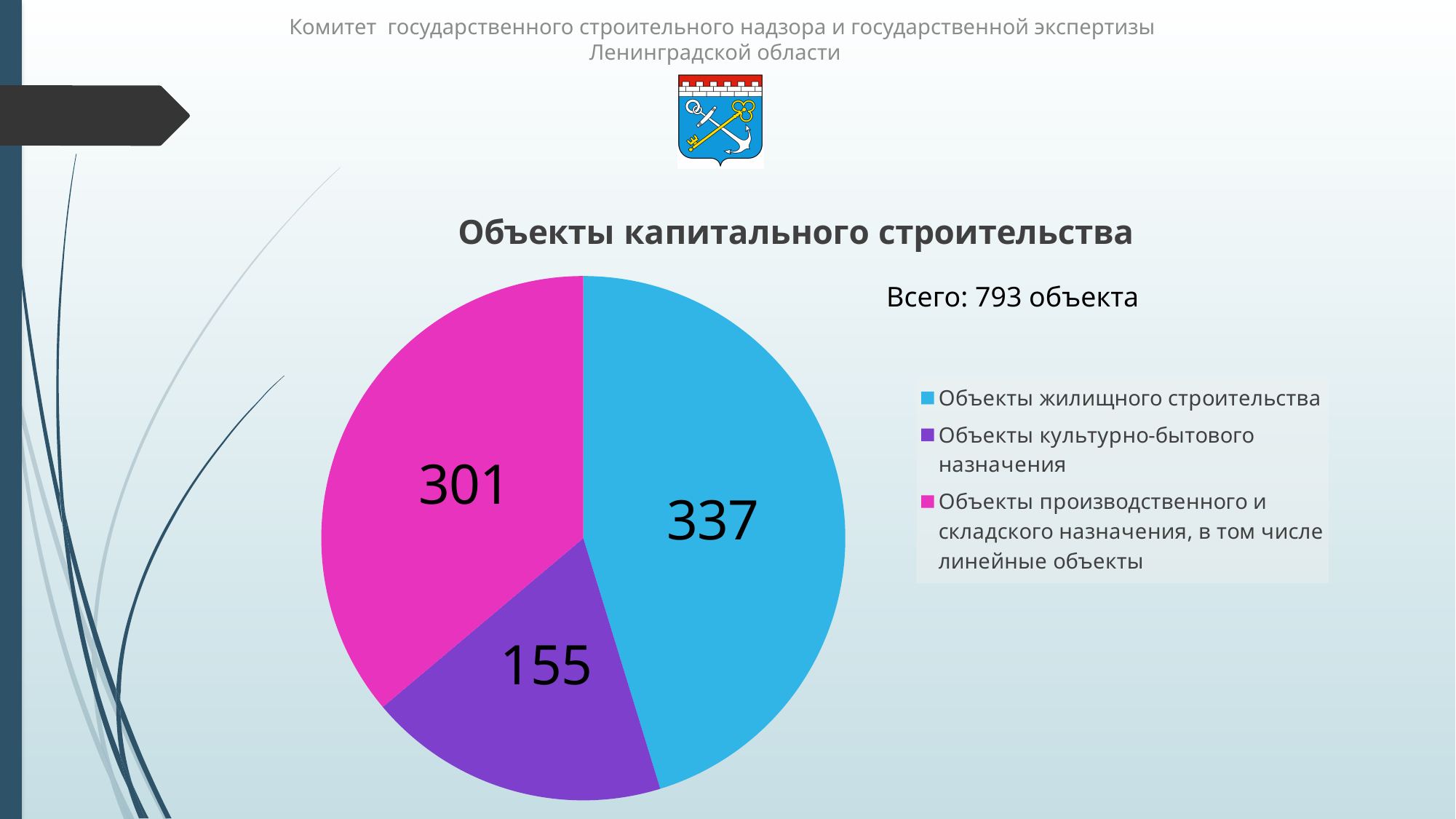
Which is larger: the value for Объекты жилищного строительства or the value for Объекты производственного и складского назначения? Объекты жилищного строительства How many entries does the legend list? 3 Which category has the largest slice of the pie? Объекты жилищного строительства What is the value for Объекты жилищного строительства? 337 What is the title of the chart? Объекты капитального строительства What is the value for Объекты культурно-бытового назначения? 155 How many slices does the pie chart have? 3 Which category has the smallest slice of the pie? Объекты культурно-бытового назначения What is the value for Объекты производственного и складского назначения, в том числе линейные объекты? 301 What is the difference between the values for Объекты жилищного строительства and Объекты культурно-бытового назначения? 182 What type of chart is shown on the slide? pie chart What is the total number of objects shown on the slide? 793